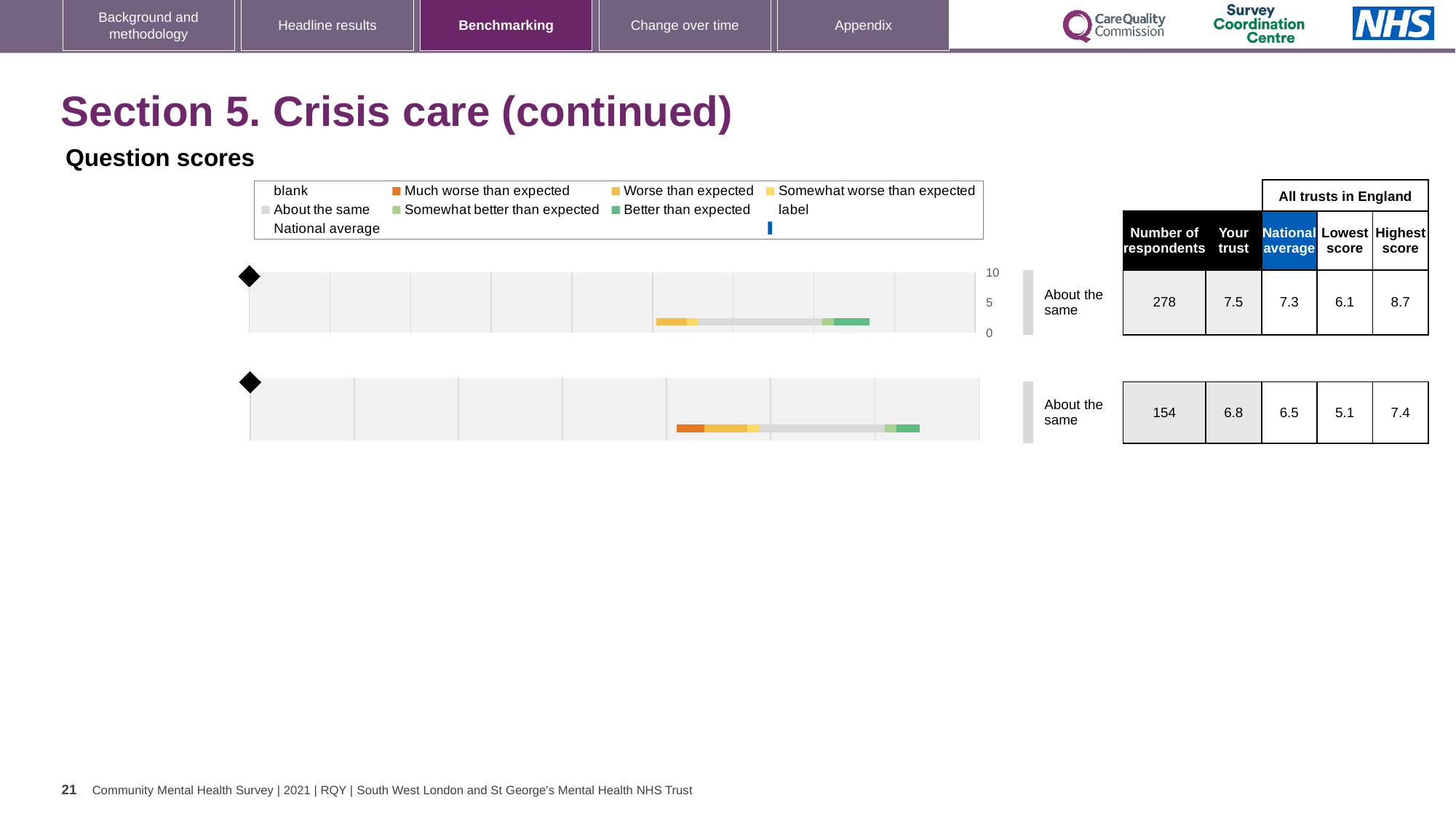
For the top chart, what is the difference between the highest score and the lowest score? 2.6 For the top chart, what is the 'Your trust' score shown in the table? 7.5 In the legend, what colour represents 'Much worse than expected'? orange For the bottom chart, what is the highest score among all trusts in England? 7.4 What is the maximum value shown on the score axis of the top chart? 10 For the top chart, what is the national average score? 7.3 For the bottom chart, what is the difference between the 'Your trust' score and the national average? 0.3 For the top chart, how many respondents are there? 278 For the bottom chart, what is the 'Your trust' score? 6.8 What kind of chart is used on this slide to show the question scores? bar chart For the bottom chart, is the 'Your trust' score greater or less than 5? greater Which chart has more respondents, the top chart or the bottom chart? top chart